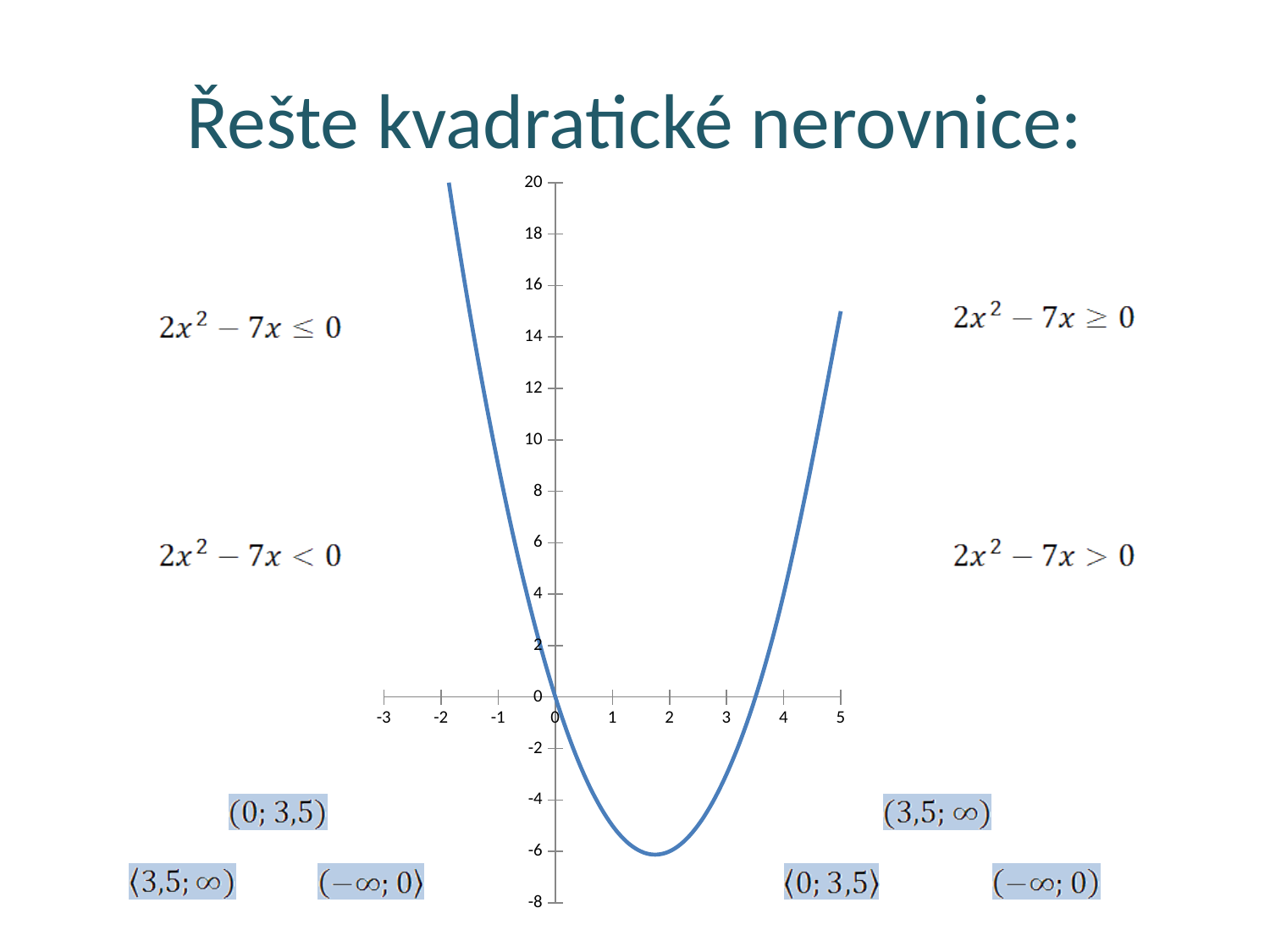
Does the curve rise or fall as x goes from 0 to 1? fall Does the curve rise or fall as x goes from 2 to 5? rise Is the value of the curve at x = 5 greater or less than 10? greater What kind of chart is shown on the slide? line chart Is the value of the curve at x = 1 greater or less than 0? less Which of the two values is larger: the curve at x = -1 or the curve at x = 4? x = -1 What is the highest value shown on the vertical axis? 20 Is the value of the curve at x = -1 greater or less than 6? greater What is the lowest value shown on the horizontal axis? -3